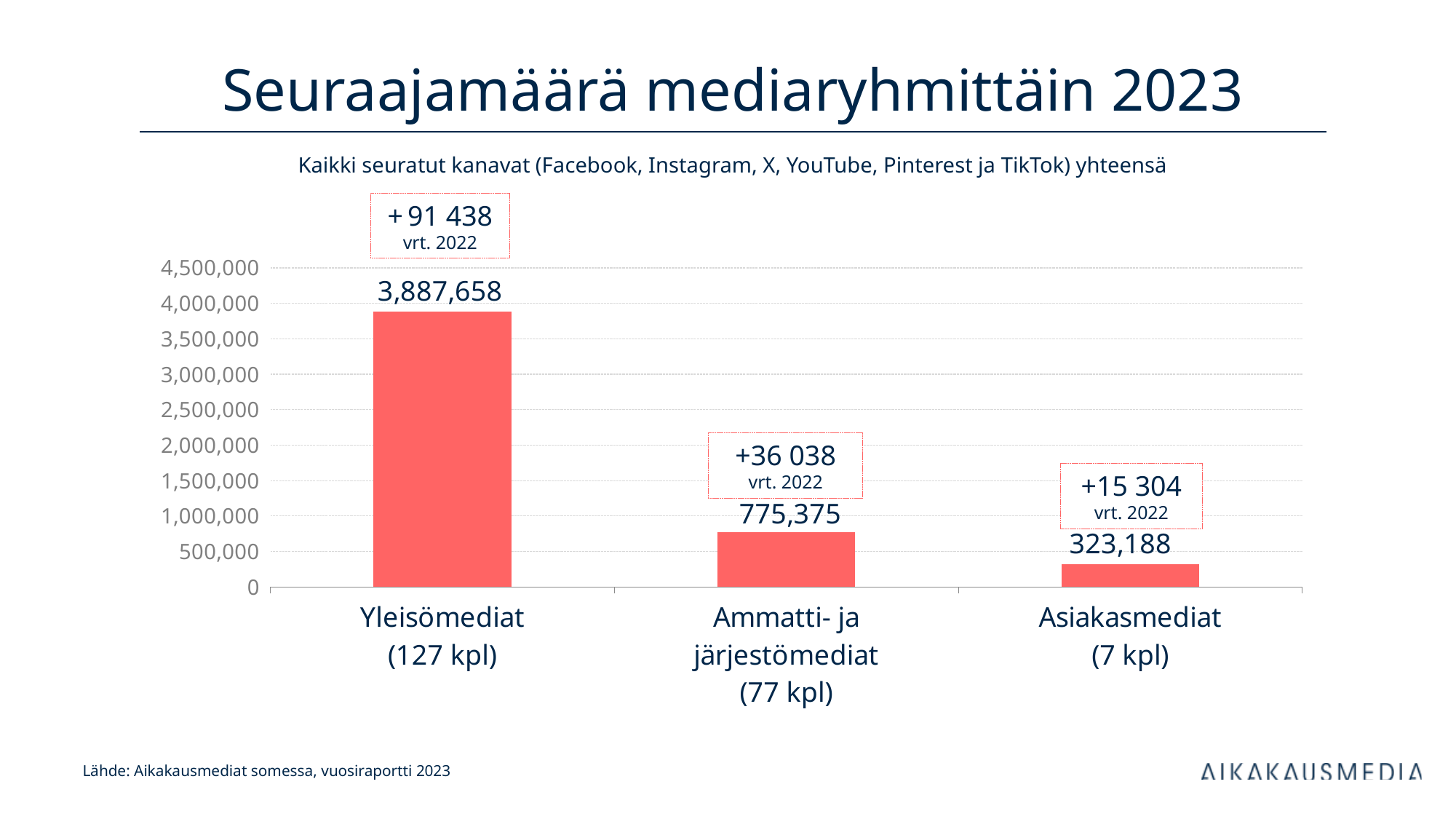
Which media group has the highest follower count? Yleisömediat What is the difference in follower count between Ammatti- ja järjestömediat and Asiakasmediat? 452,187 What kind of chart is shown on the slide? bar chart Which media group has the lowest follower count? Asiakasmediat What is the difference in follower count between Yleisömediat and Ammatti- ja järjestömediat? 3,112,283 Is the value for Yleisömediat greater or less than 3,500,000? greater What is the follower count for Asiakasmediat? 323,188 Which has more followers, Ammatti- ja järjestömediat or Asiakasmediat? Ammatti- ja järjestömediat What is the change compared to 2022 shown for Yleisömediat? +91 438 How many media groups are shown in the chart? 3 What is the follower count for Yleisömediat? 3,887,658 What is the follower count for Ammatti- ja järjestömediat? 775,375